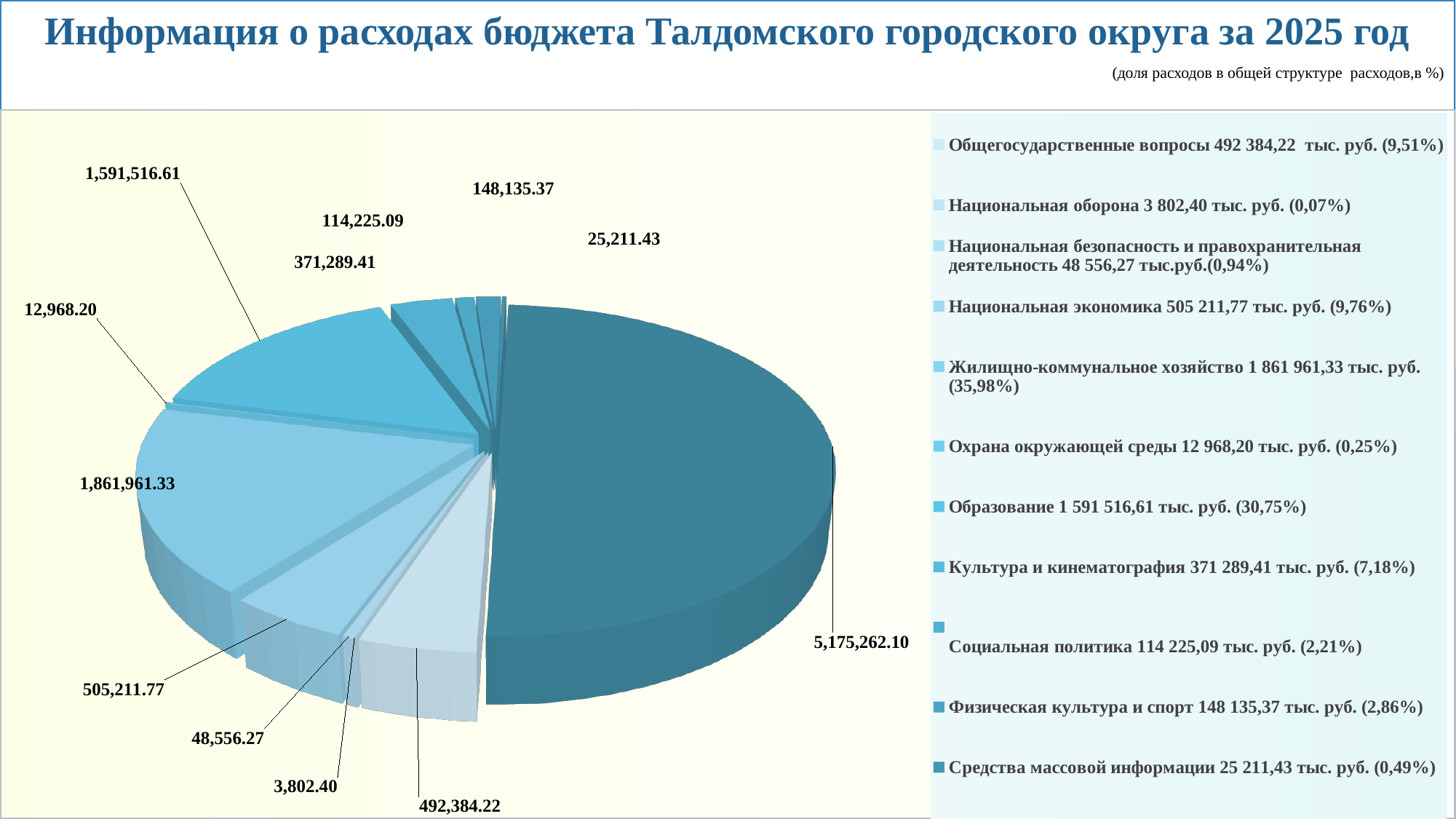
What is the value of the slice for Физическая культура и спорт? 148,135.37 How many entries does the legend list? 11 According to the legend, what share of total expenditure does Образование represent? 30,75% What is the value of the slice for Жилищно-коммунальное хозяйство? 1,861,961.33 What is the value of the slice for Национальная экономика? 505,211.77 What is the largest value labelled on the pie chart? 5,175,262.10 Which is larger: the value for Культура и кинематография or the value for Социальная политика? Культура и кинематография Which legend category has the smallest value on the pie chart? Национальная оборона What is the difference between the values for Жилищно-коммунальное хозяйство and Образование? 270,444.72 What kind of chart is shown on the slide? pie chart How many slices are labelled with values on the pie chart? 12 What is the value of the slice for Образование? 1,591,516.61